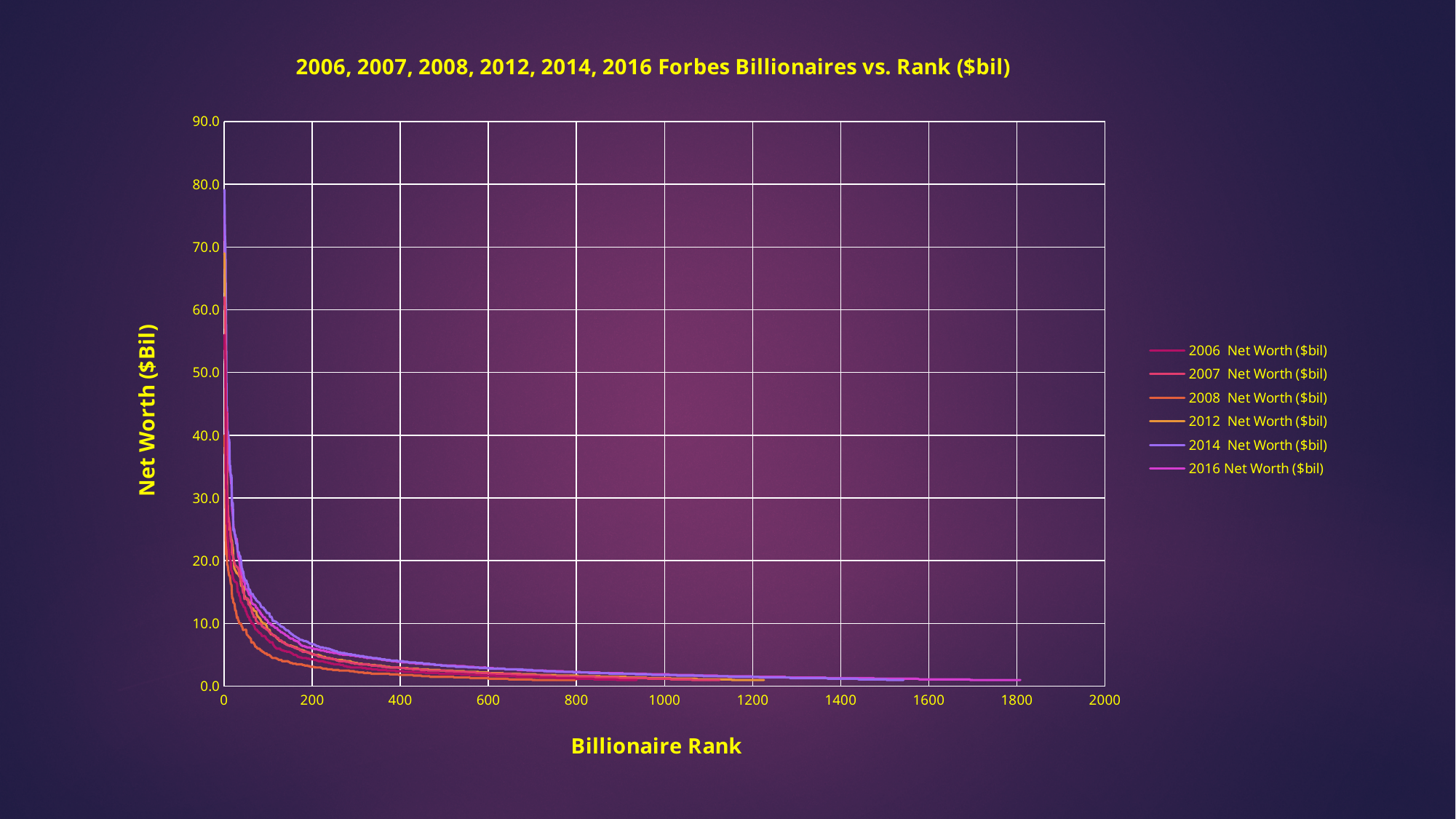
Is the 2014 Net Worth value at rank 400 greater or less than 10.0? less Is the 2008 Net Worth value at rank 600 greater or less than 10.0? less What is the label of the vertical axis? Net Worth ($Bil) What is the highest value shown on the vertical axis? 90.0 How many series does the legend list? 6 Which series extends to the highest billionaire rank on the x axis? 2016 Net Worth ($bil) Is the 2016 Net Worth value at rank 1000 greater or less than 10.0? less What is the title of the chart? 2006, 2007, 2008, 2012, 2014, 2016 Forbes Billionaires vs. Rank ($bil) What kind of chart is shown on the slide? line chart Do the net worth values rise or fall as billionaire rank increases along the x axis? fall